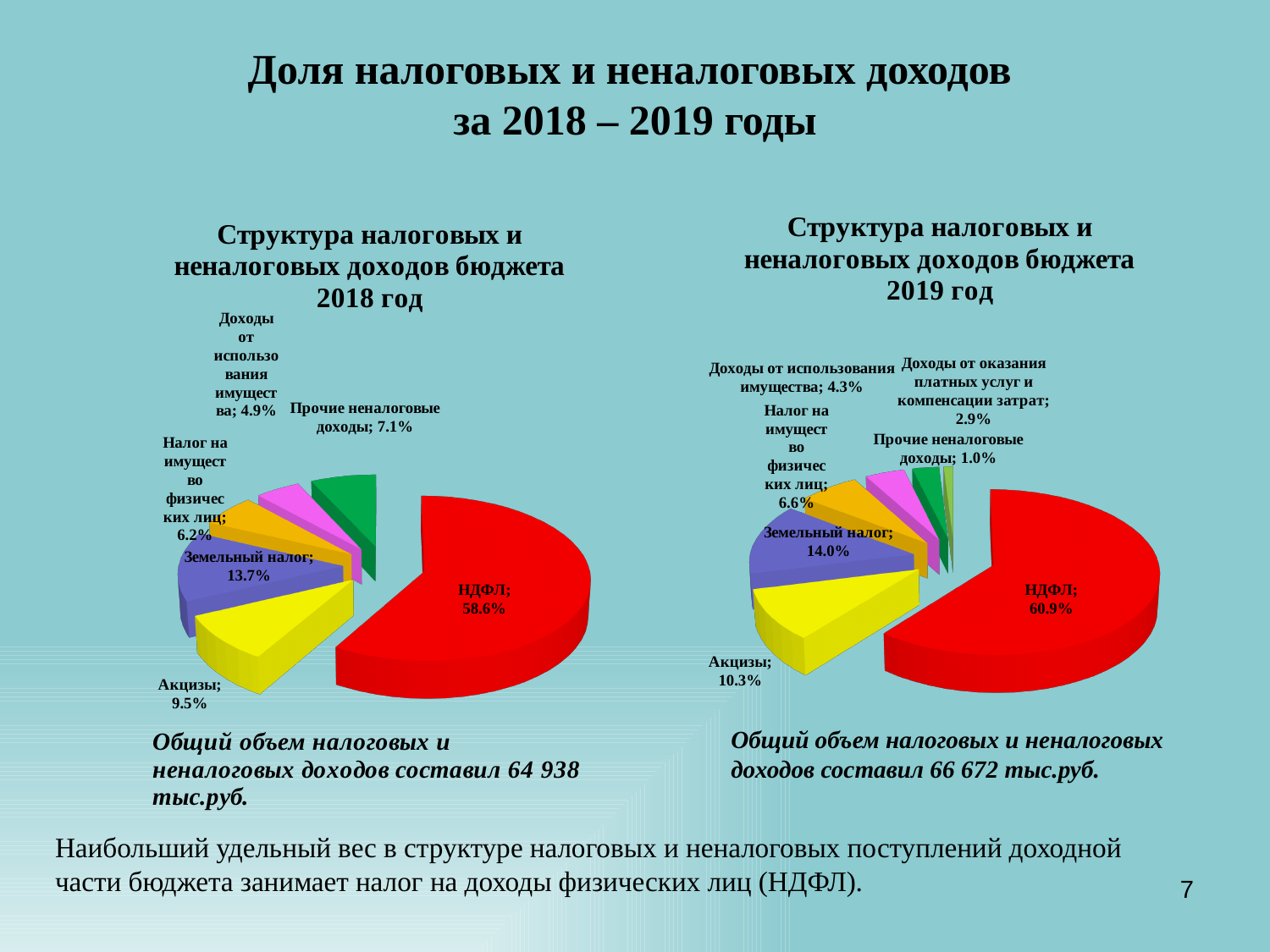
In the 2019 chart (right), what share does Земельный налог have? 14.0% What is the title of the chart on the right? Структура налоговых и неналоговых доходов бюджета 2019 год In the 2018 chart (left), what share does НДФЛ have? 58.6% In the 2018 chart (left), which category has the smallest share? Доходы от использования имущества In the 2019 chart (right), what share do Прочие неналоговые доходы have? 1.0% In the 2019 chart (right), which category has the smallest share? Прочие неналоговые доходы In the 2018 chart (left), which category has the largest share? НДФЛ How many slices does the 2018 chart (left) have? 6 What type of chart is used on this slide? Pie chart In the 2018 chart (left), which is larger: Акцизы or Прочие неналоговые доходы? Акцизы What is the difference between the НДФЛ share in the 2019 chart and the НДФЛ share in the 2018 chart? 2.3% How many slices does the 2019 chart (right) have? 7